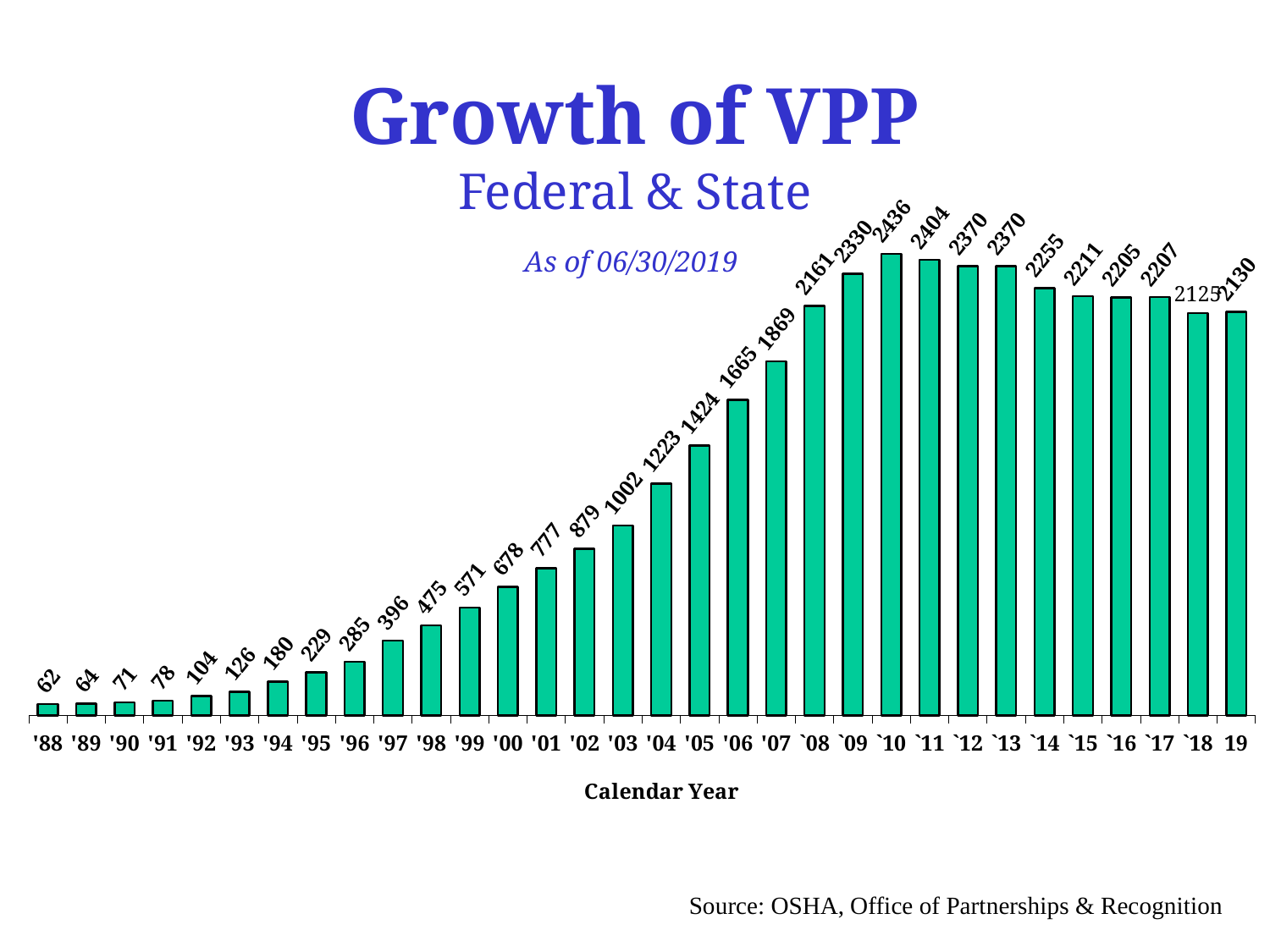
What is the difference between the values for '10 and '11? 32 Do the values rise or fall from '88 to '10? Rise What is the difference between the values for '19 and '18? 5 How many years are shown on the x axis? 32 What is the value for '00? 678 What is the title of the x axis? Calendar Year What kind of chart is this? Bar chart What is the value for '88? 62 Which year has the lowest value? '88 What is the value for '10? 2436 Which year has the highest value? '10 Which is larger, the value for '05 or the value for '06? '06